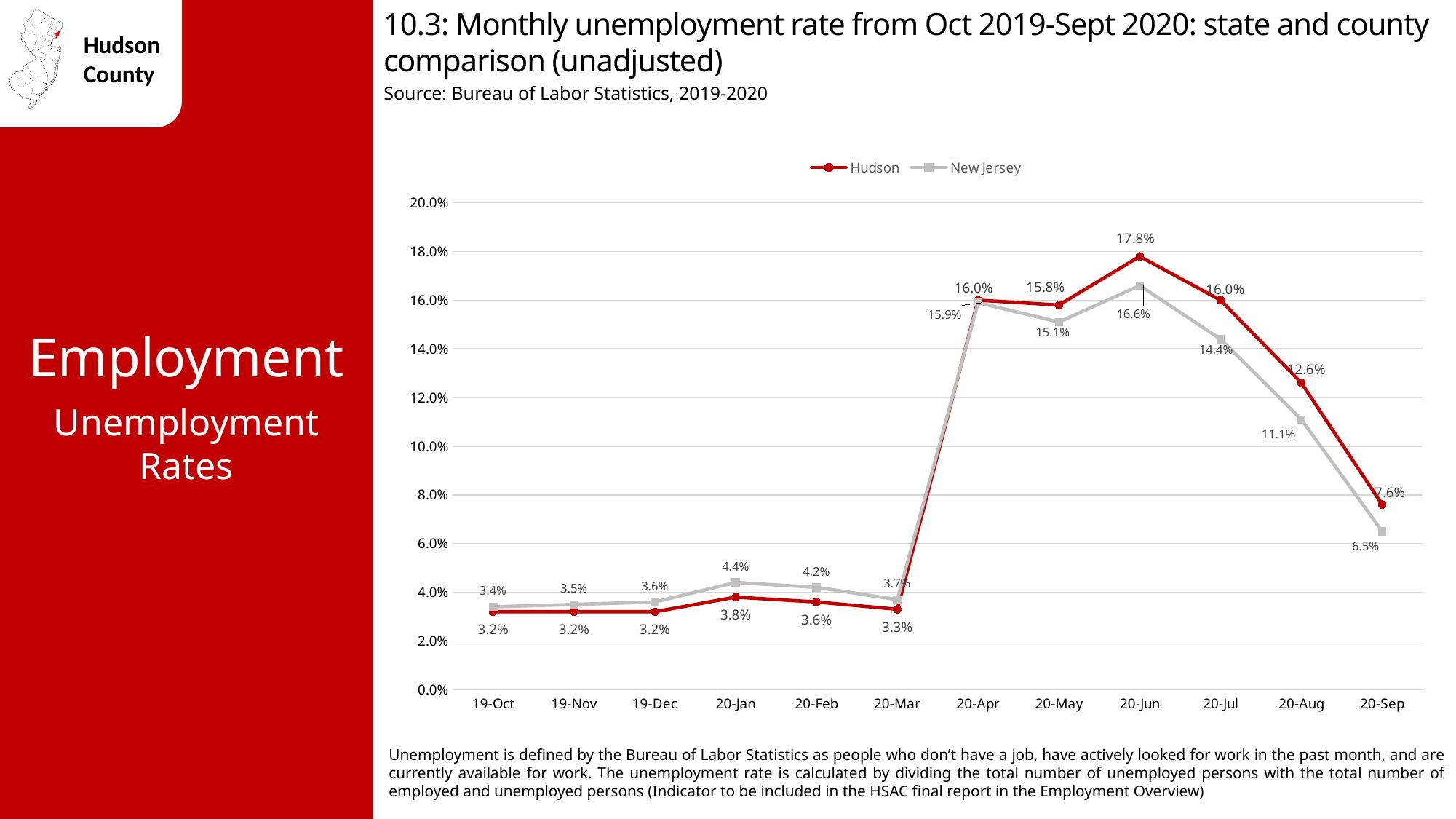
In which month did the Hudson unemployment rate reach its highest value? 20-Jun In 20-Feb, which had the higher unemployment rate, Hudson or New Jersey? New Jersey How many months are shown on the x axis? 12 In which month was the New Jersey unemployment rate lowest? 19-Oct What was the Hudson unemployment rate in 20-Sep? 7.6% What was the Hudson unemployment rate in 20-Jun? 17.8% What was the New Jersey unemployment rate in 20-Jan? 4.4% How many series does the legend list? 2 What kind of chart is shown on the slide? Line chart What is the difference between the Hudson and New Jersey unemployment rates in 20-Jul? 1.6% What was the New Jersey unemployment rate in 20-Aug? 11.1% Did the Hudson unemployment rate rise or fall from 20-Jun to 20-Sep? Fall